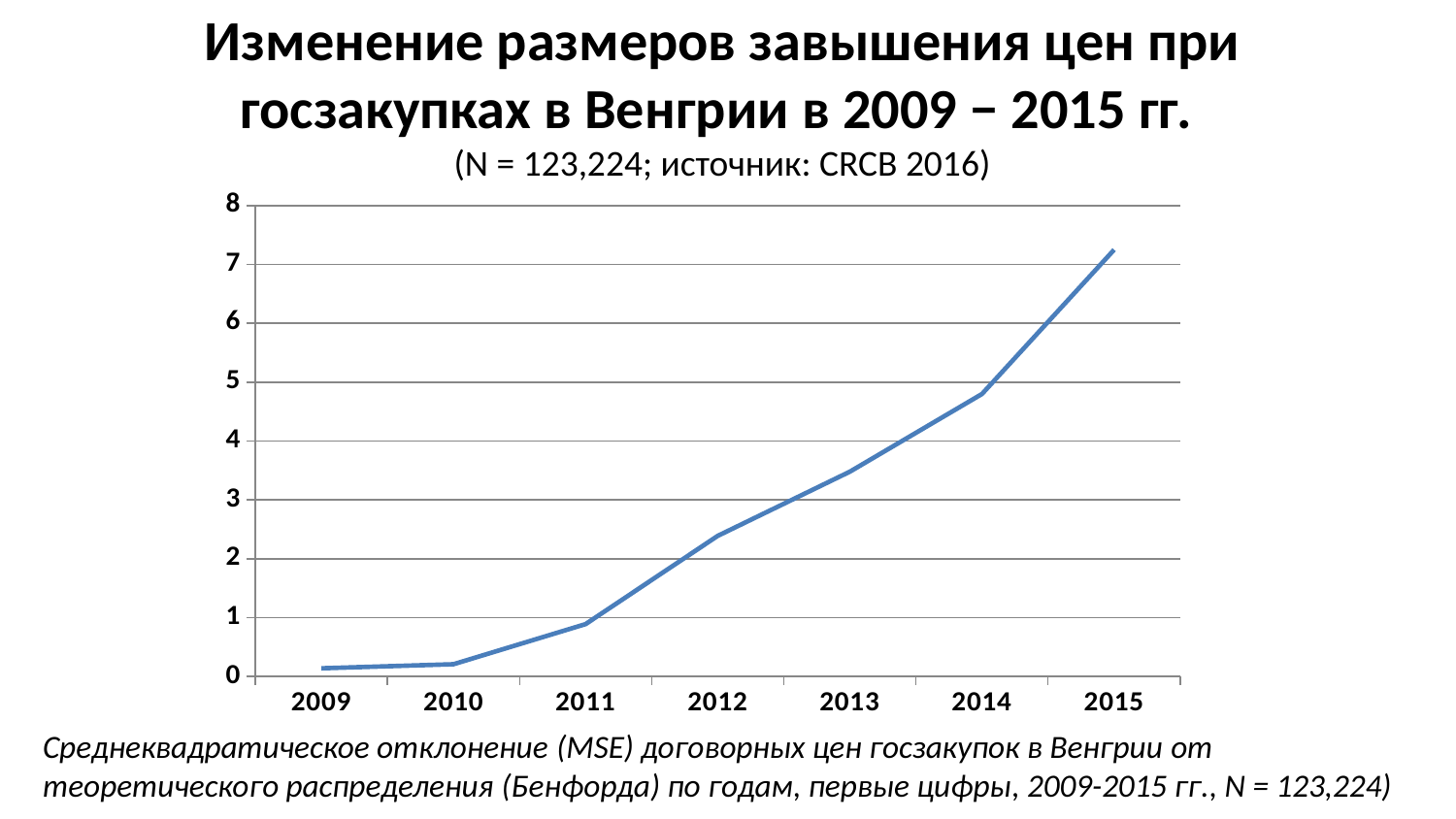
Is the value for 2013 greater or less than 3? greater Is the value for 2014 greater or less than 5? less Is the value for 2015 greater or less than 7? greater What is the maximum value shown on the y axis? 8 What kind of chart is shown on the slide? line chart How many years are plotted along the x axis? 7 Do the values rise or fall from 2009 to 2015? rise Which year has the highest value on the chart? 2015 Which is larger, the value for 2013 or the value for 2014? 2014 What sample size N is given in the chart subtitle? 123,224